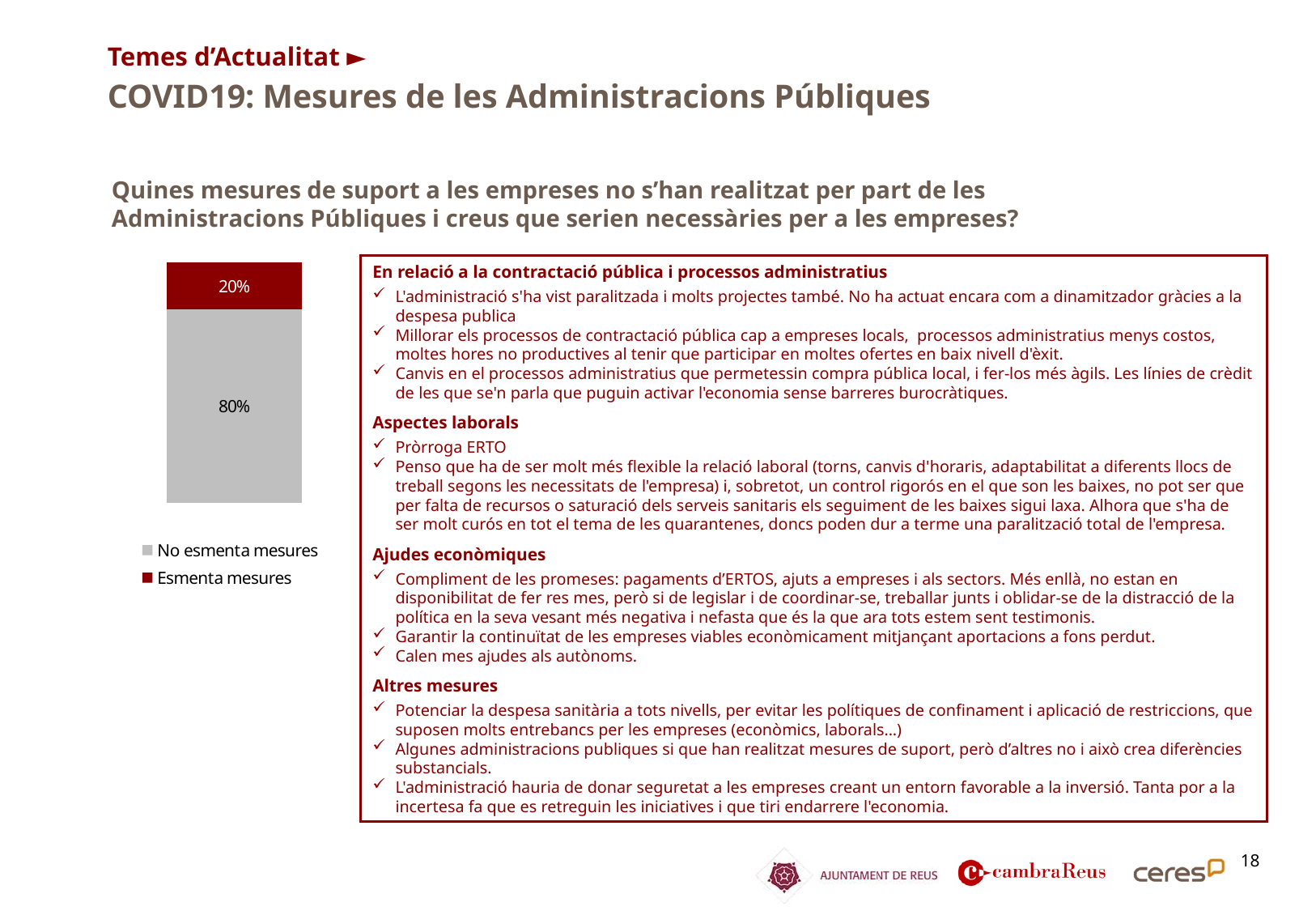
Is the value for "Esmenta mesures" greater or less than 50%? less How many series does the chart legend list? 2 What is the total of the two segments in the stacked bar? 100% What is the difference in percentage points between "No esmenta mesures" and "Esmenta mesures"? 60 What percentage of respondents are shown as "No esmenta mesures" in the chart? 80% What percentage of respondents are shown as "Esmenta mesures" in the chart? 20% Which colour represents "Esmenta mesures" in the chart? Dark red What kind of chart is shown on the slide? Stacked bar chart Which colour represents "No esmenta mesures" in the chart? Grey Which category has the largest share in the chart? No esmenta mesures Which segment of the bar is larger, "No esmenta mesures" or "Esmenta mesures"? No esmenta mesures Which category has the smallest share in the chart? Esmenta mesures